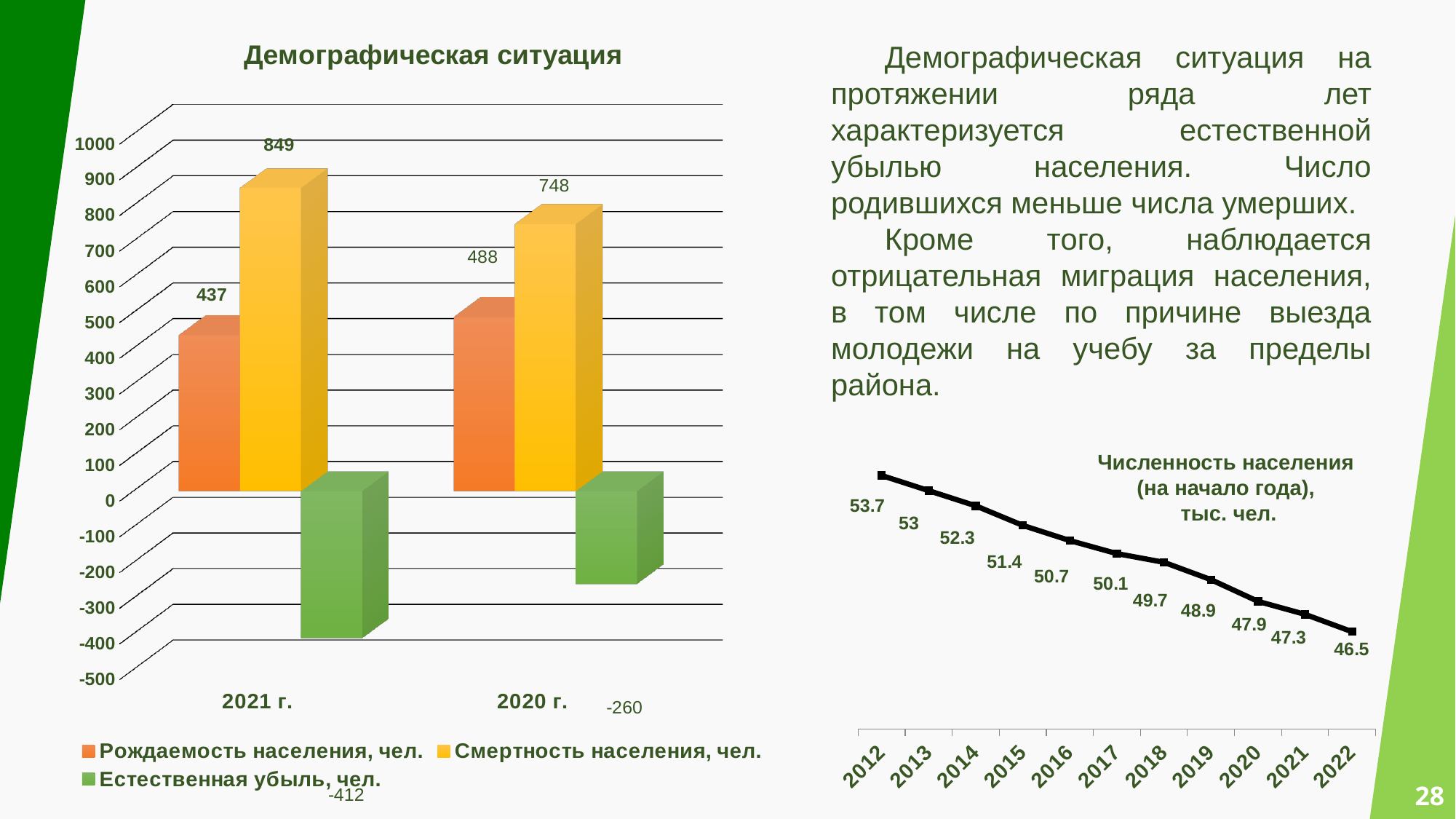
In the chart titled 'Демографическая ситуация', what is the value of 'Смертность населения, чел.' for 2021 г.? 849 In the chart titled 'Демографическая ситуация', how many series does the legend list? 3 In the chart titled 'Численность населения (на начало года), тыс. чел.', what is the value for 2022? 46.5 In the chart titled 'Численность населения (на начало года), тыс. чел.', how many years are plotted on the x axis? 11 In the chart titled 'Демографическая ситуация', what is the difference between 'Смертность населения, чел.' and 'Рождаемость населения, чел.' in 2020 г.? 260 In the chart titled 'Численность населения (на начало года), тыс. чел.', do the values rise or fall from 2012 to 2022? Fall In the chart titled 'Демографическая ситуация', which year has the higher value of 'Смертность населения, чел.', 2021 г. or 2020 г.? 2021 г. What type of chart is the chart titled 'Демографическая ситуация'? Bar chart In the chart titled 'Демографическая ситуация', what is the value of 'Естественная убыль, чел.' for 2021 г.? -412 In the chart titled 'Демографическая ситуация', what is the value of 'Рождаемость населения, чел.' for 2020 г.? 488 In the chart titled 'Численность населения (на начало года), тыс. чел.', what is the value for 2012? 53.7 In the chart titled 'Численность населения (на начало года), тыс. чел.', which year has the lowest value? 2022